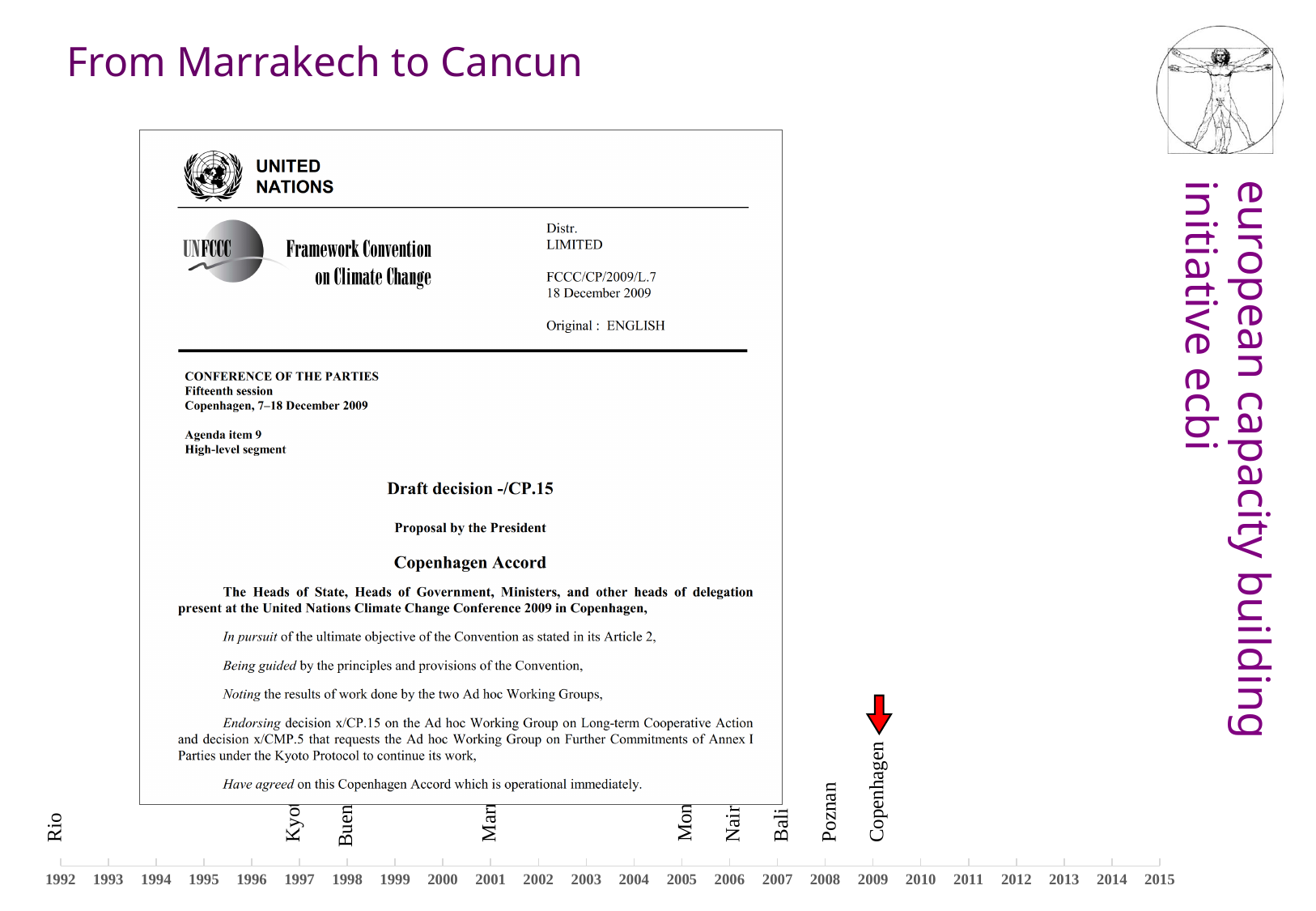
What is the first year shown on the timeline axis at the bottom of the slide? 1992 What kind of chart is shown at the bottom of the slide? A timeline What is the last year shown on the timeline axis at the bottom of the slide? 2015 What is the title of the slide? From Marrakech to Cancun On the timeline at the bottom of the slide, which year is Copenhagen placed at? 2009 On the timeline at the bottom of the slide, which year is Bali placed at? 2007 How many year labels are shown on the timeline axis at the bottom of the slide? 24 On the timeline, which comes earlier, Bali or Poznan? Bali On the timeline at the bottom of the slide, which year is Poznan placed at? 2008 On the timeline, how many years separate Rio and Copenhagen? 17 On the timeline at the bottom of the slide, which year is Rio placed at? 1992 Which event on the timeline is marked with a red arrow? Copenhagen